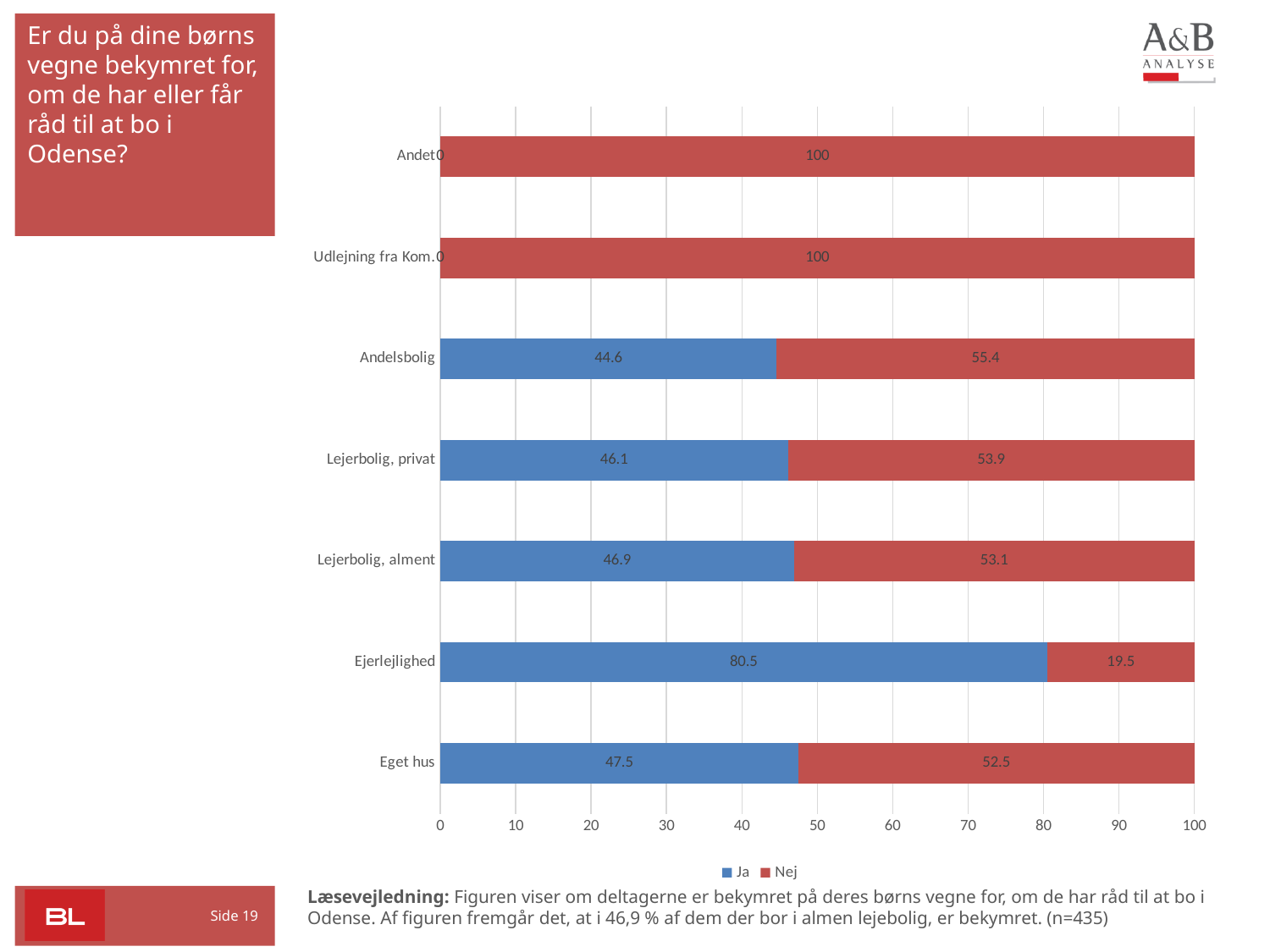
Which category has the lowest "Nej" value? Ejerlejlighed Which category has the highest "Ja" value? Ejerlejlighed How many series does the legend list? 2 What is the "Nej" value for Andelsbolig? 55.4 What is the "Nej" value for Udlejning fra Kom.? 100 What is the "Ja" value for Ejerlejlighed? 80.5 How many categories are shown on the chart? 7 What is the total of the stacked bar for Lejerbolig, privat? 100 What is the "Ja" value for Lejerbolig, alment? 46.9 Which is larger: the "Ja" value for Lejerbolig, privat or the "Ja" value for Andelsbolig? Lejerbolig, privat What is the difference between the "Ja" and "Nej" values for Eget hus? 5 What kind of chart is shown on the slide? Stacked bar chart